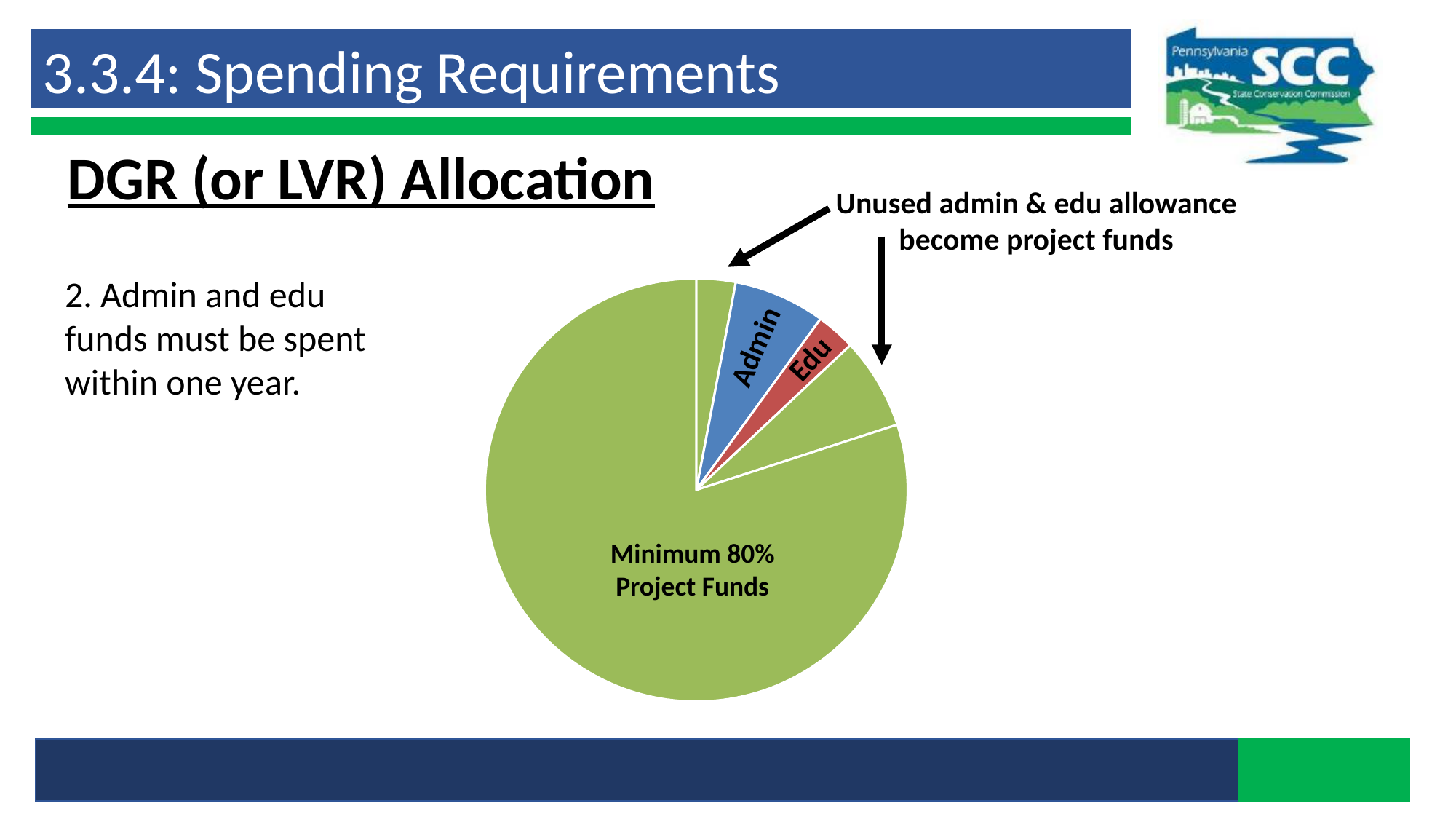
Which slice of the pie chart is the largest? Minimum 80% Project Funds What colour is the Edu slice in the pie chart? red Which slice is larger, Admin or Edu? Admin What kind of chart is shown on the slide? pie chart What colour is the Admin slice in the pie chart? blue What is the heading above the pie chart on the slide? DGR (or LVR) Allocation Is the Project Funds slice greater or less than 50% of the pie? greater How many slices in the pie chart have a text label? 3 What minimum share of the allocation is labeled for Project Funds in the pie chart? 80% Is the Edu slice greater or less than 25% of the pie? less